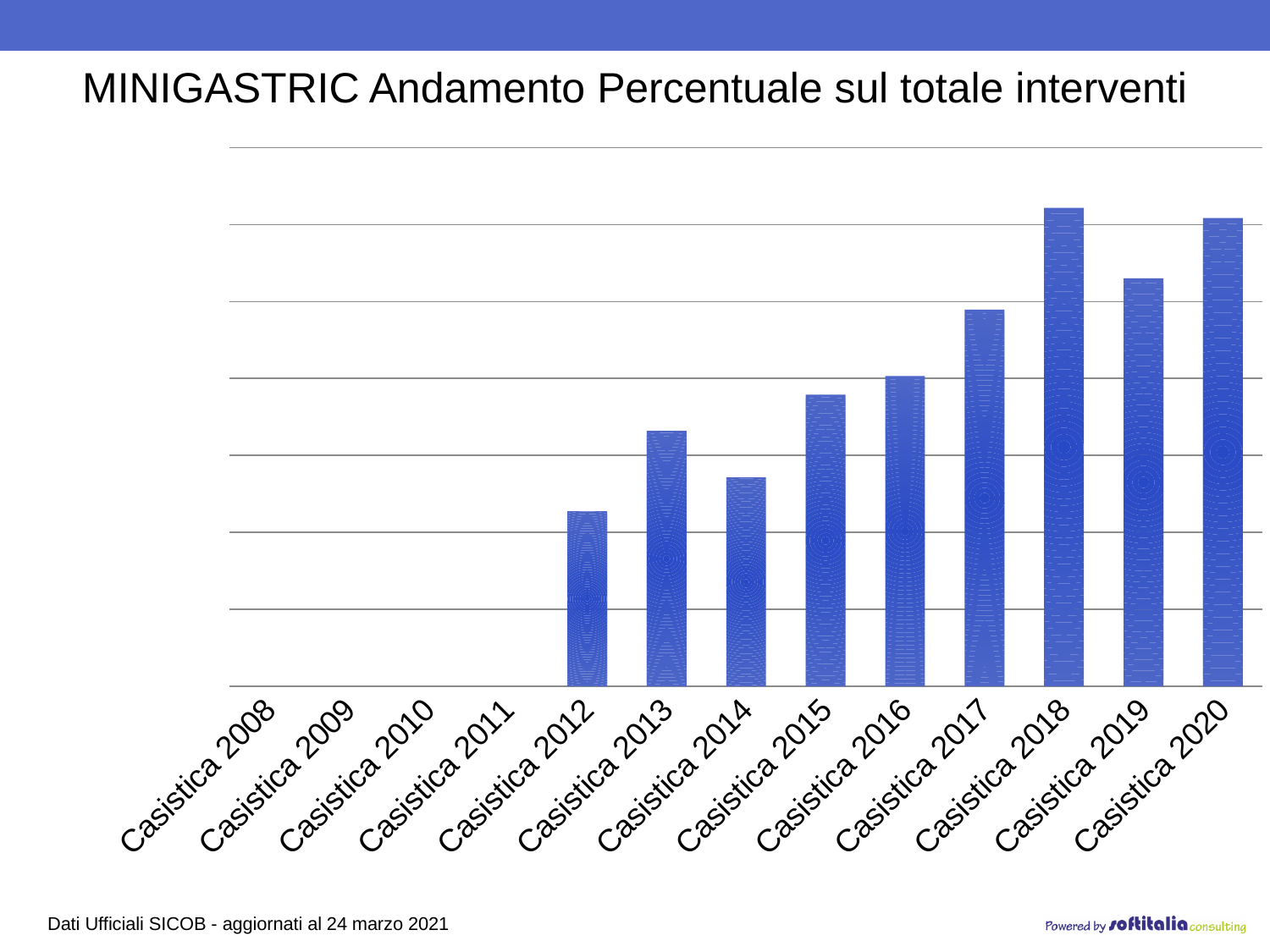
How many categories have a visible bar? 9 What is the title of the chart? MINIGASTRIC Andamento Percentuale sul totale interventi What is the first category on the x axis that shows a visible bar? Casistica 2012 Which is larger, the value for Casistica 2012 or Casistica 2015? Casistica 2015 Among the categories with a visible bar, which has the shortest bar? Casistica 2012 What kind of chart is shown on the slide? bar chart Do the values generally rise or fall from Casistica 2012 to Casistica 2018? rise Which is larger, the value for Casistica 2019 or Casistica 2020? Casistica 2020 Which category has the tallest bar? Casistica 2018 How many categories are listed along the x axis? 13 Which is larger, the value for Casistica 2016 or Casistica 2017? Casistica 2017